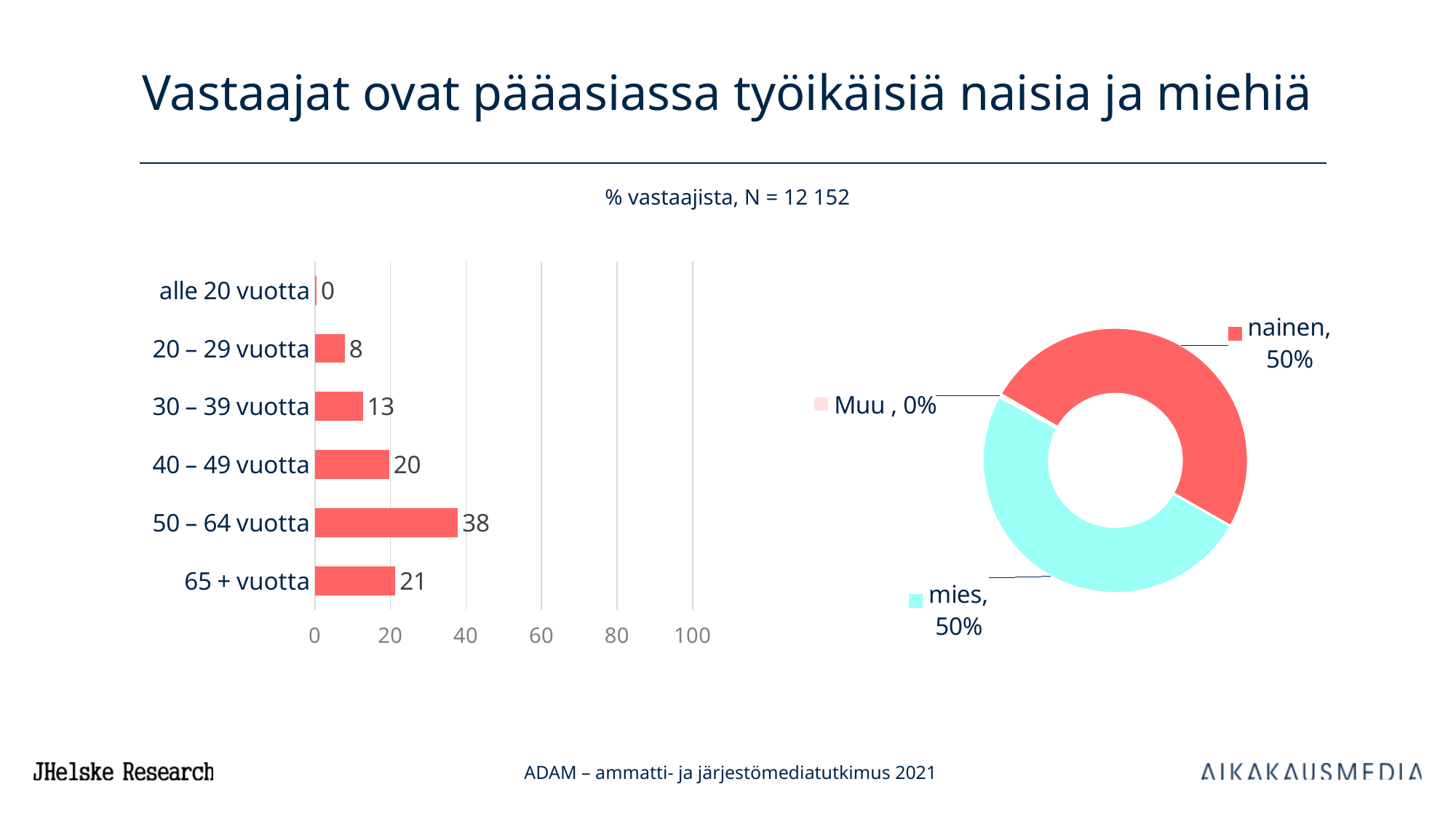
What is the subtitle text shown above the charts? % vastaajista, N = 12 152 In the bar chart on the left, what is the value for 20 – 29 vuotta? 8 In the bar chart on the left, which age group has the lowest value? alle 20 vuotta What kind of chart is the chart on the left? bar chart In the bar chart on the left, which age group has the highest value? 50 – 64 vuotta In the bar chart on the left, what is the value for 65 + vuotta? 21 In the bar chart on the left, what is the value for 50 – 64 vuotta? 38 In the doughnut chart on the right, what share is labelled for mies? 50% In the bar chart on the left, which is larger: the value for 65 + vuotta or the value for 30 – 39 vuotta? 65 + vuotta In the bar chart on the left, what is the difference between the values for 50 – 64 vuotta and 40 – 49 vuotta? 18 How many age categories are shown in the bar chart on the left? 6 In the doughnut chart on the right, what share is labelled for Muu? 0%